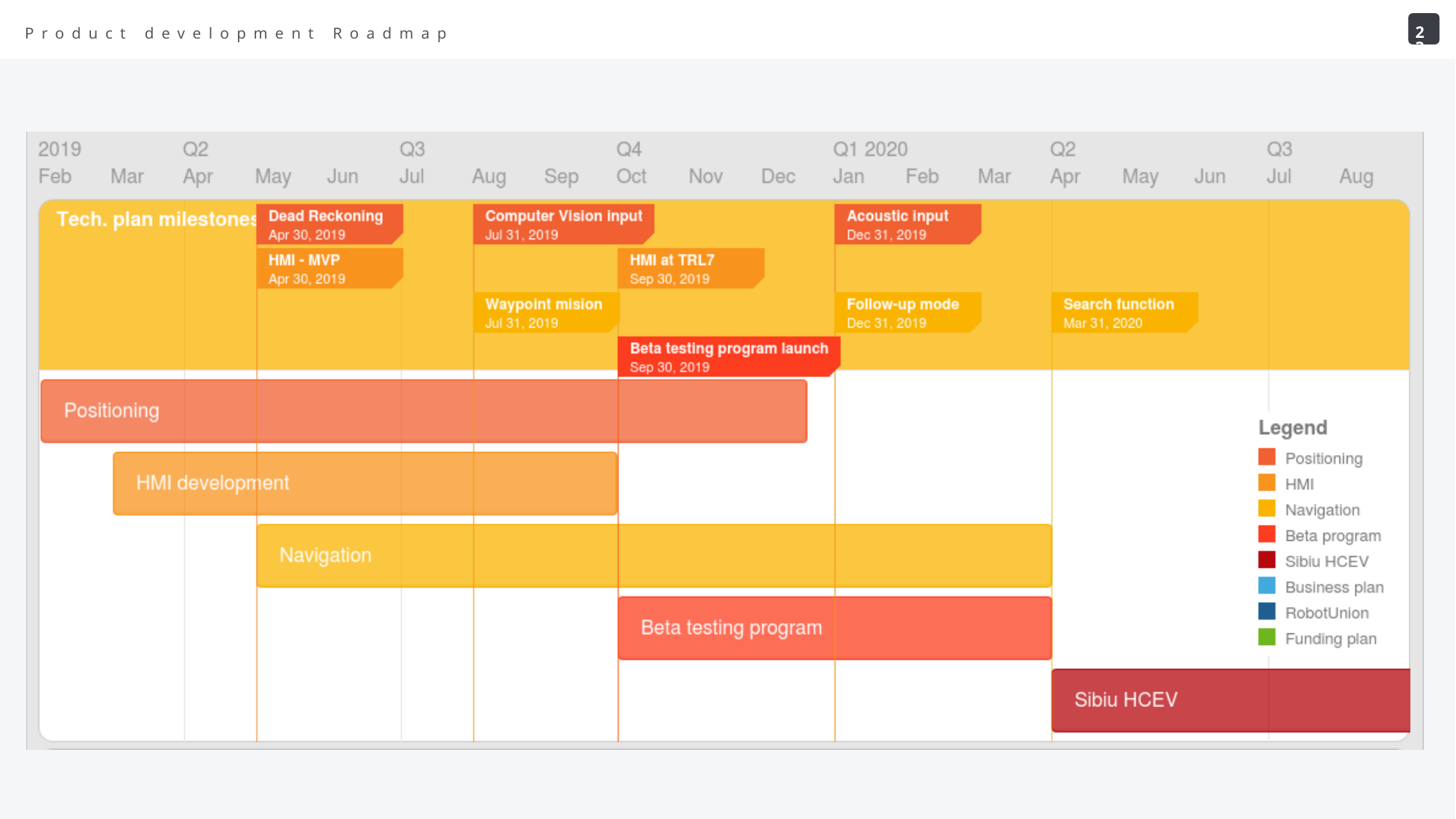
Which milestone has the latest date on the roadmap? Search function How many milestones are shown in the Tech. plan milestones band? 9 Which activity bar starts earliest on the timeline? Positioning What date is shown for the Computer Vision input milestone? Jul 31, 2019 What date is shown for the Search function milestone? Mar 31, 2020 What date is shown for the Beta testing program launch milestone? Sep 30, 2019 Which activity bar starts latest on the timeline? Sibiu HCEV What kind of chart is shown on the slide? Gantt chart What date is shown for the Dead Reckoning milestone? Apr 30, 2019 How many entries does the legend list? 8 Which starts earlier on the timeline, Navigation or Beta testing program? Navigation What date is shown for the Acoustic input milestone? Dec 31, 2019